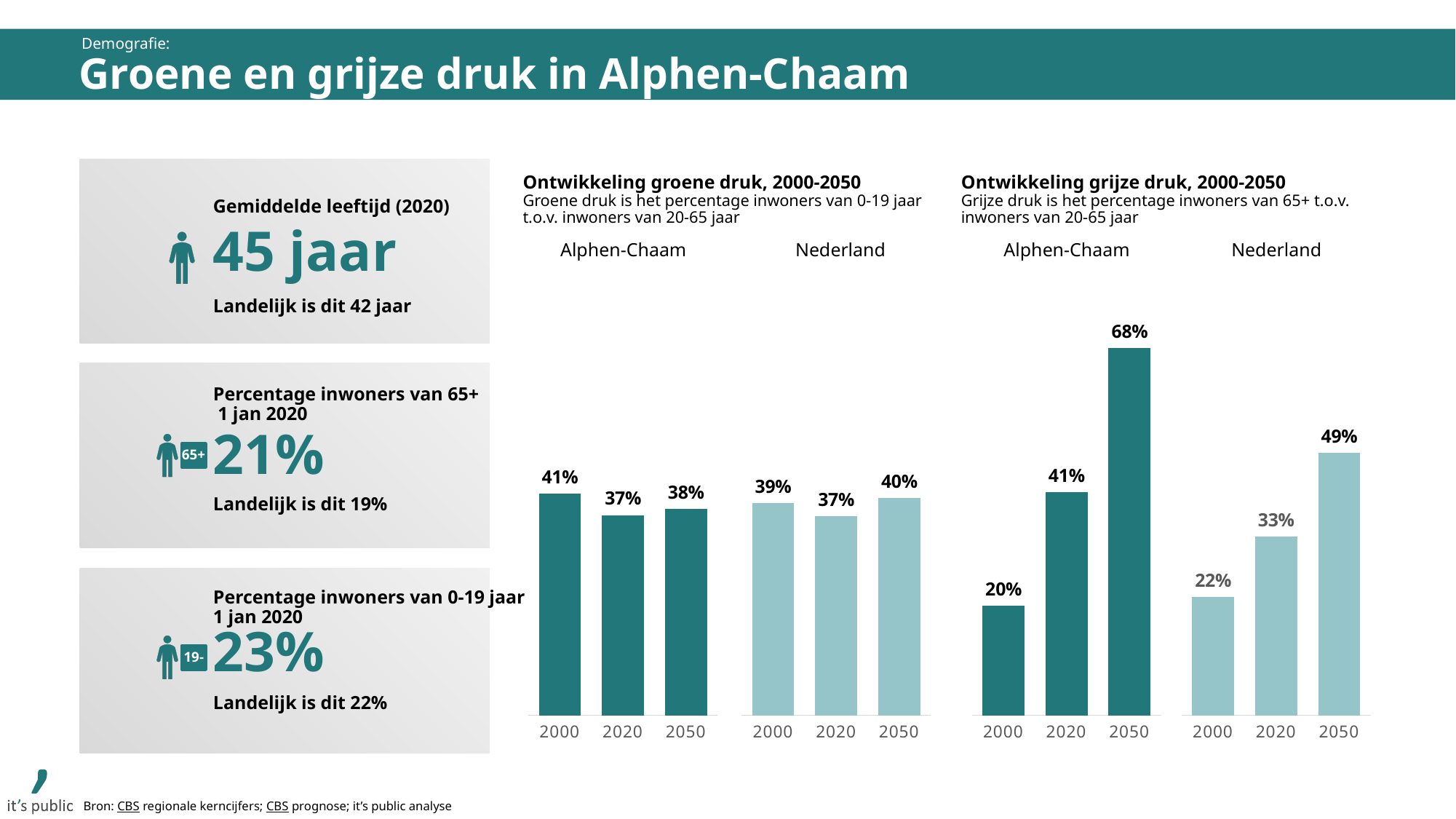
In the chart 'Ontwikkeling grijze druk, 2000-2050', do the Alphen-Chaam values rise or fall from 2000 to 2050? rise In the chart 'Ontwikkeling grijze druk, 2000-2050', what is the difference between the Alphen-Chaam values for 2050 and 2000? 48% In the chart 'Ontwikkeling grijze druk, 2000-2050', which bar is the highest? Alphen-Chaam 2050 What kind of chart is 'Ontwikkeling grijze druk, 2000-2050'? bar chart In the chart 'Ontwikkeling groene druk, 2000-2050', what is the value for Alphen-Chaam in 2000? 41% In the chart 'Ontwikkeling grijze druk, 2000-2050', what is the value for Alphen-Chaam in 2050? 68% How many bars are shown in the chart 'Ontwikkeling groene druk, 2000-2050'? 6 In the chart 'Ontwikkeling grijze druk, 2000-2050', what is the value for Nederland in 2020? 33% In the chart 'Ontwikkeling groene druk, 2000-2050', what is the value for Nederland in 2050? 40% In the chart 'Ontwikkeling grijze druk, 2000-2050', which bar is the lowest? Alphen-Chaam 2000 In the chart 'Ontwikkeling groene druk, 2000-2050', what is the difference between the Alphen-Chaam value and the Nederland value in 2000? 2% In the chart 'Ontwikkeling grijze druk, 2000-2050', which is larger in 2050: Alphen-Chaam or Nederland? Alphen-Chaam